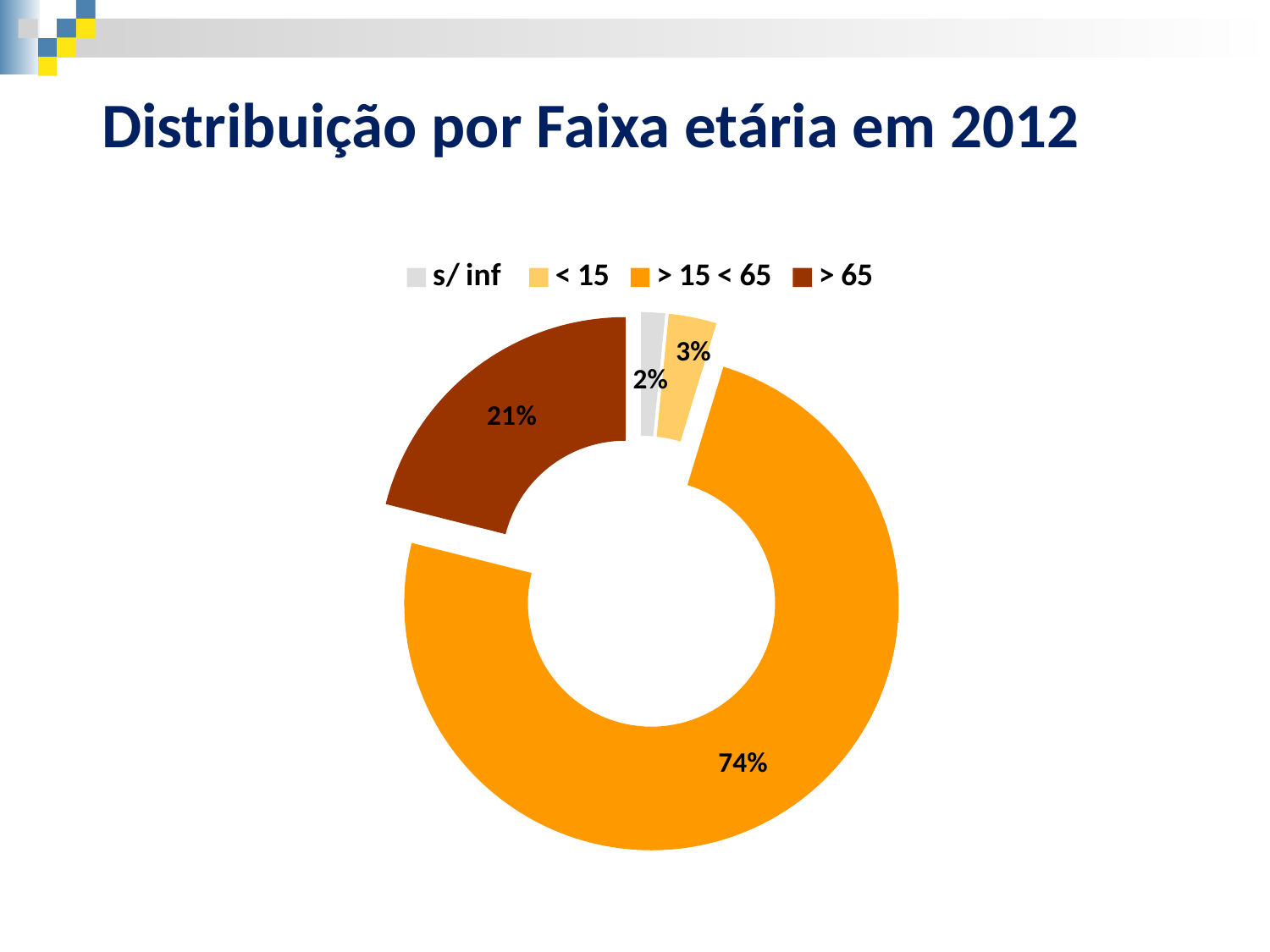
What share of the doughnut chart does the "> 65" category hold? 21% Which is larger, the share for "< 15" or the share for "s/ inf"? < 15 What kind of chart is shown on the slide? Doughnut (pie) chart How many categories does the legend list? 4 What is the value shown for the "< 15" category? 3% What is the value shown for the "s/ inf" category? 2% Which category has the largest share of the chart? > 15 < 65 What is the difference between the shares of "> 15 < 65" and "> 65"? 53% What share of the doughnut chart does the "> 15 < 65" category hold? 74% Which category has the smallest share of the chart? s/ inf Which category is shown in grey in the legend? s/ inf What is the title of the slide? Distribuição por Faixa etária em 2012